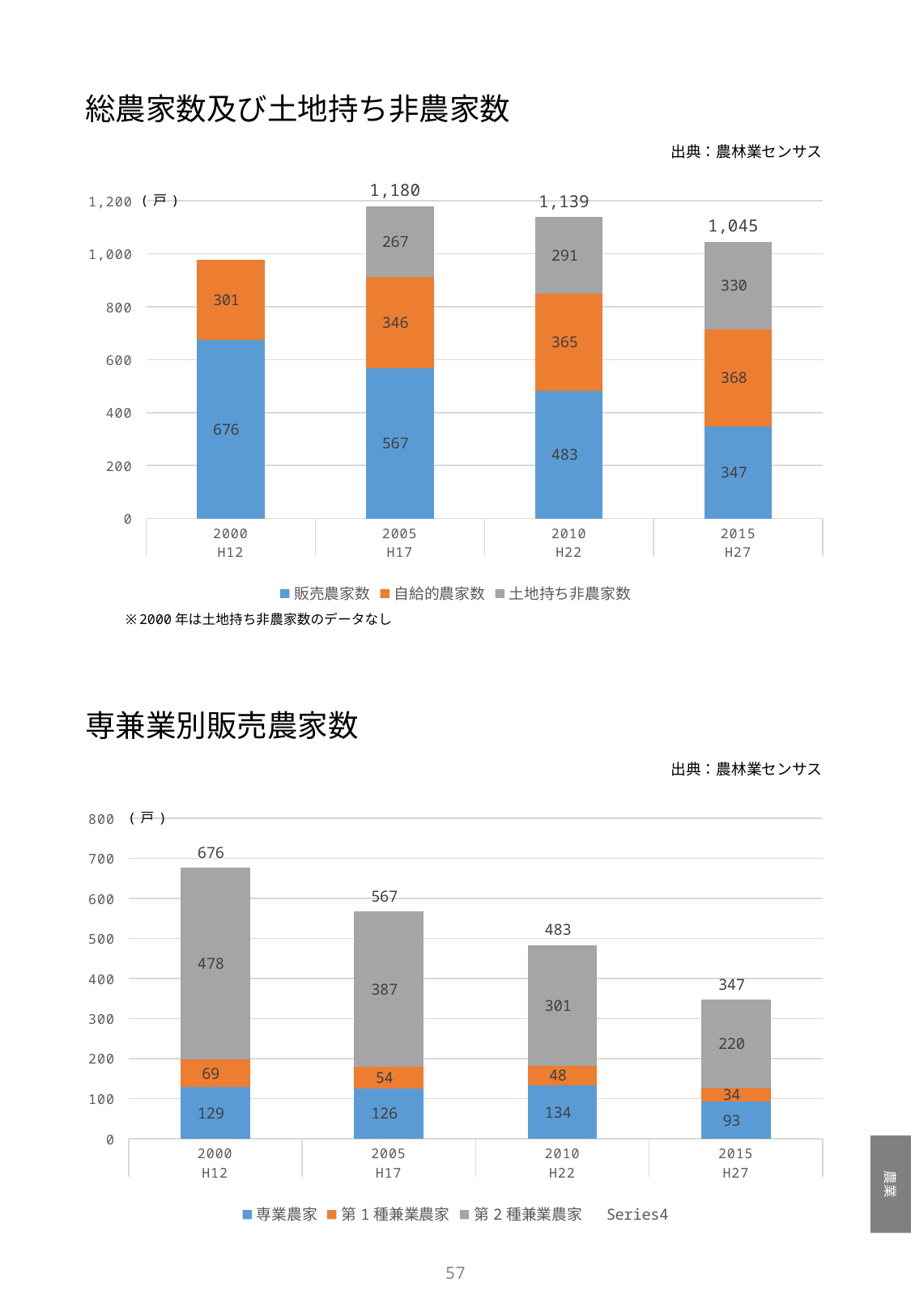
In the top chart (総農家数及び土地持ち非農家数), what is the value of 販売農家数 for 2000 (H12)? 676 In the bottom chart (専兼業別販売農家数), what is the value of 第2種兼業農家 for 2005 (H17)? 387 In the top chart (総農家数及び土地持ち非農家数), what is the difference between 販売農家数 in 2005 and in 2015? 220 In the top chart (総農家数及び土地持ち非農家数), how many series does the legend list? 3 In the bottom chart (専兼業別販売農家数), what is the total of the 2010 (H22) stacked bar? 483 In the bottom chart (専兼業別販売農家数), which is larger: 専業農家 in 2010 or 専業農家 in 2000? 2010 In the top chart (総農家数及び土地持ち非農家数), which year has the highest labelled total? 2005 (H17) In the bottom chart (専兼業別販売農家数), which year has the lowest value of 専業農家? 2015 (H27) In the top chart (総農家数及び土地持ち非農家数), what is the value of 土地持ち非農家数 for 2010 (H22)? 291 What kind of chart is the bottom chart (専兼業別販売農家数)? stacked bar chart In the top chart (総農家数及び土地持ち非農家数), does 販売農家数 rise or fall from 2000 to 2015? fall In the top chart (総農家数及び土地持ち非農家数), what is the total shown above the 2015 (H27) bar? 1,045